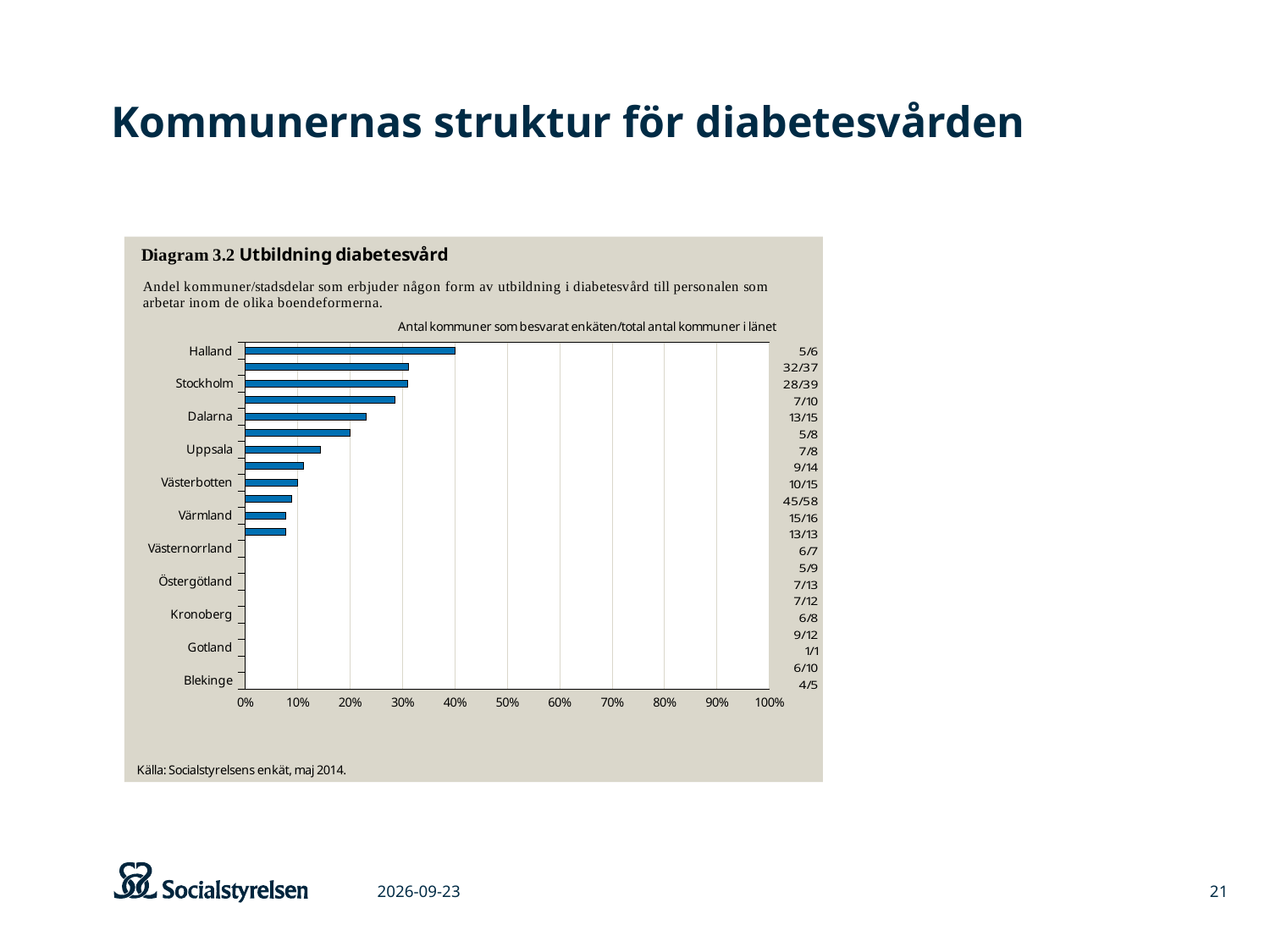
Do the bar values rise or fall going from Halland at the top down to Blekinge at the bottom? fall Is the value for Värmland greater or less than 10%? less What kind of chart is shown in Diagram 3.2? bar chart Is the value for Dalarna greater or less than 30%? less What is the number of responding municipalities out of the total shown to the right of the chart for Stockholm? 28/39 What is the number of responding municipalities out of the total shown to the right of the chart for Halland? 5/6 Which has a larger value, Halland or Dalarna? Halland Is the value for Halland greater or less than 30%? greater Which county has the highest share in Diagram 3.2 Utbildning diabetesvård? Halland How many county names are labelled on the vertical axis of the chart? 11 What is the title of the diagram on the slide? Diagram 3.2 Utbildning diabetesvård